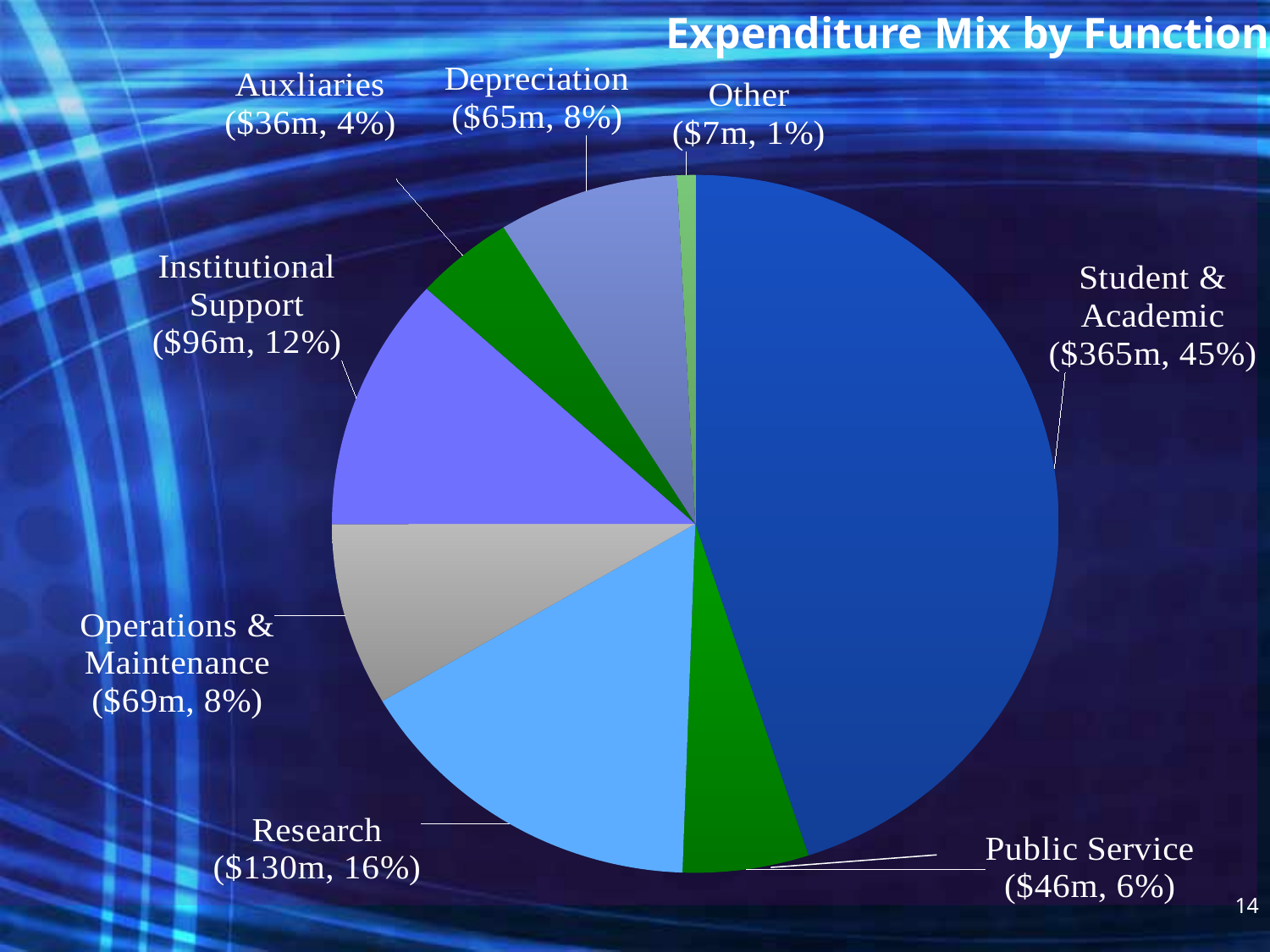
What is the difference in dollars between Institutional Support and Auxliaries? $60m Which category has the largest slice? Student & Academic What percentage share does Institutional Support have? 12% What is the difference in dollars between Student & Academic and Research? $235m Which category has the smallest slice? Other What share of the pie does Public Service represent? 6% What is the dollar value for Operations & Maintenance? $69m How many slices does the pie chart have? 8 What is the title of the chart? Expenditure Mix by Function Which is larger, Depreciation or Public Service? Depreciation What kind of chart is shown on the slide? pie chart What is the dollar value for Research? $130m